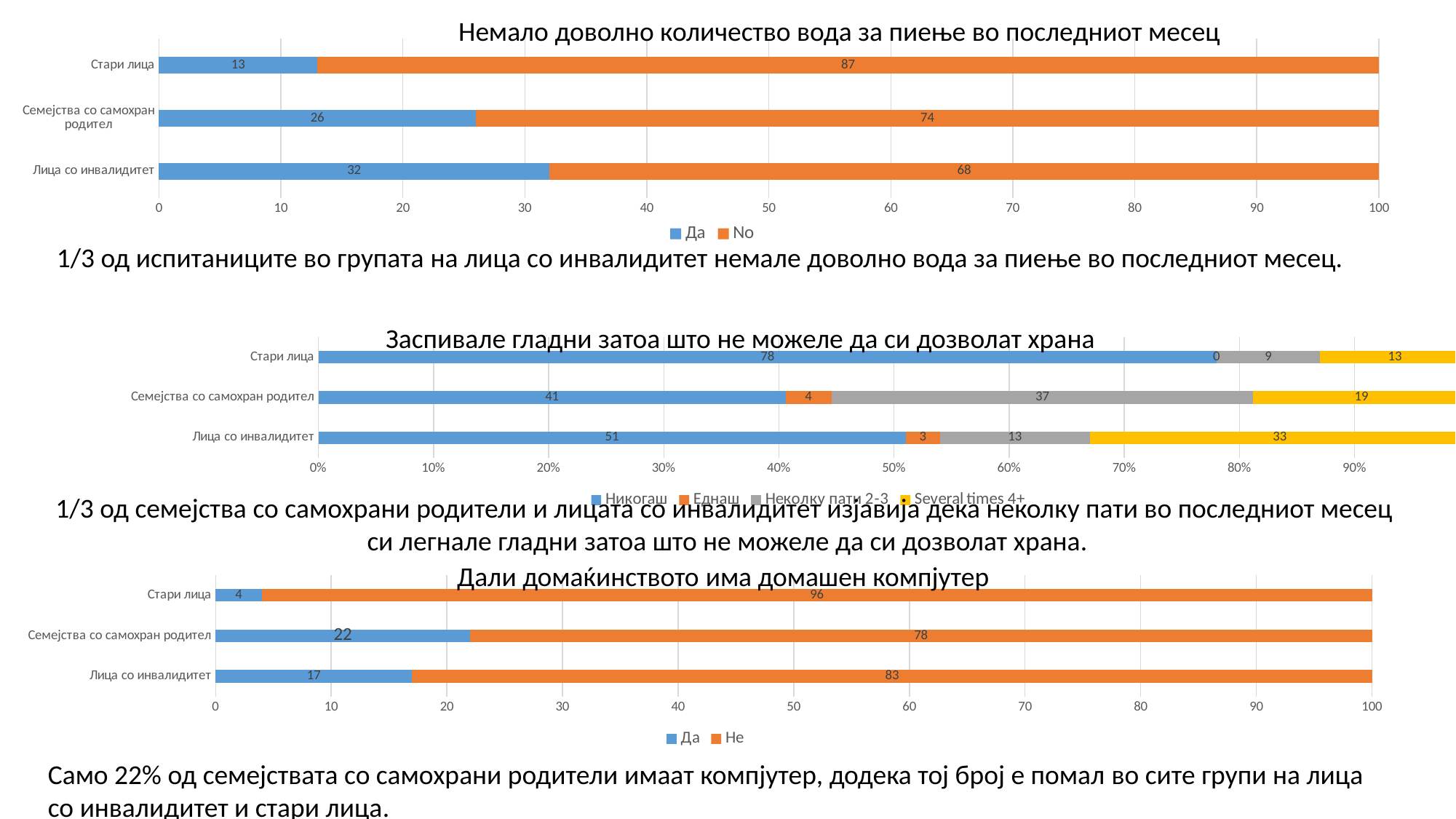
In the chart titled "Немало доволно количество вода за пиење во последниот месец", which category has the highest "No" value? Стари лица How many categories are shown in the chart titled "Немало доволно количество вода за пиење во последниот месец"? 3 In the chart titled "Заспивале гладни затоа што не можеле да си дозволат храна", what is the value of "Неколку пати 2-3" for "Семејства со самохран родител"? 37 In the chart titled "Заспивале гладни затоа што не можеле да си дозволат храна", how many series does the legend list? 4 In the chart titled "Немало доволно количество вода за пиење во последниот месец", what is the difference between the "Да" values for "Семејства со самохран родител" and "Стари лица"? 13 In the chart titled "Дали домаќинството има домашен компјутер", which is larger: the "Не" value for "Стари лица" or for "Лица со инвалидитет"? Стари лица In the chart titled "Заспивале гладни затоа што не можеле да си дозволат храна", what is the value of "Никогаш" for "Стари лица"? 78 What kind of chart is the one titled "Дали домаќинството има домашен компјутер"? Stacked bar chart In the chart titled "Дали домаќинството има домашен компјутер", what is the value of "Да" for "Семејства со самохран родител"? 22 In the chart titled "Немало доволно количество вода за пиење во последниот месец", what is the value of "Да" for "Лица со инвалидитет"? 32 In the chart titled "Заспивале гладни затоа што не можеле да си дозволат храна", which category has the highest "Several times 4+" value? Лица со инвалидитет In the chart titled "Дали домаќинството има домашен компјутер", which category has the lowest "Да" value? Стари лица